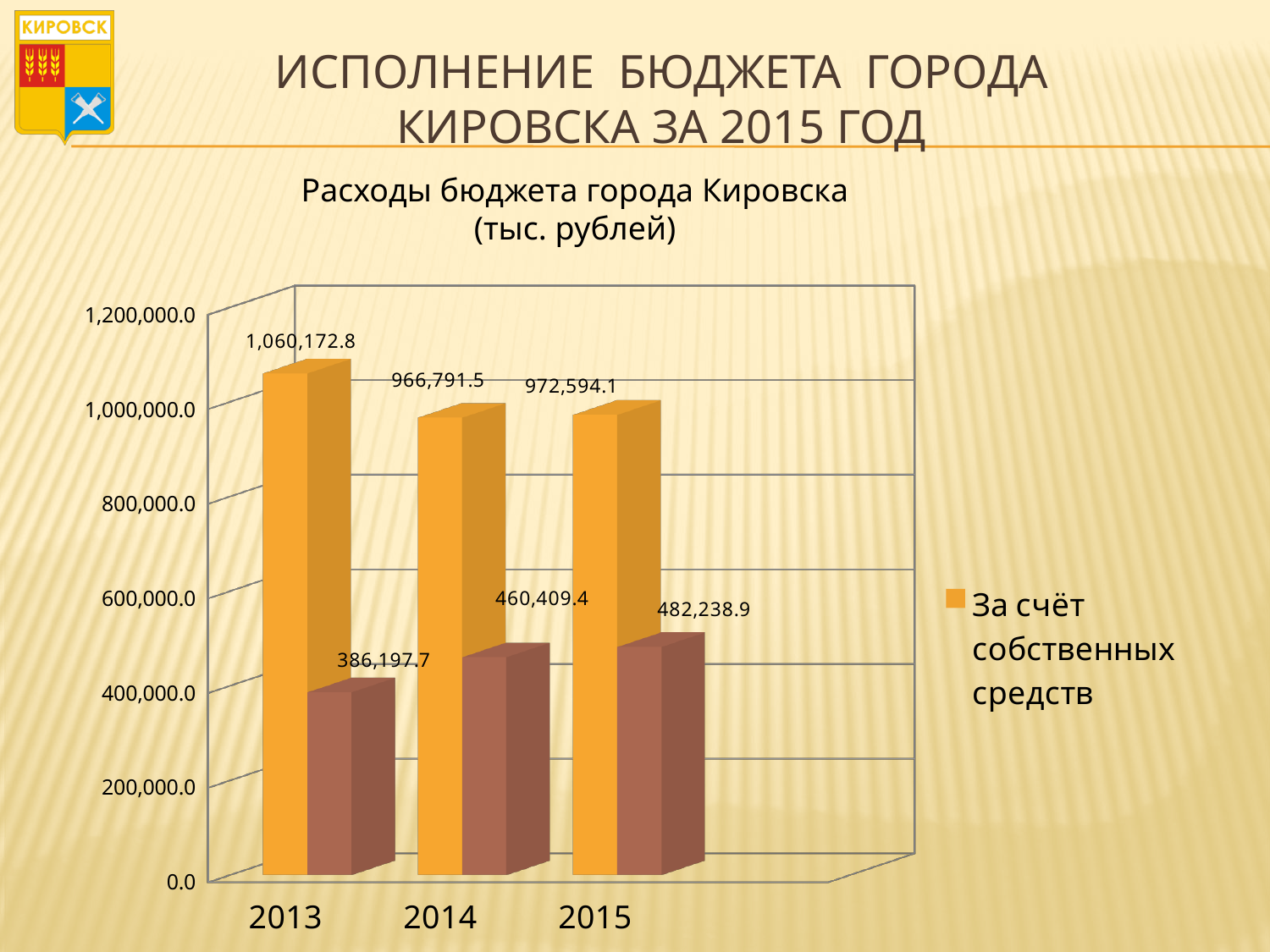
What is the title of the chart? Расходы бюджета города Кировска (тыс. рублей) By how much does the brown bar for 2015 exceed the brown bar for 2014? 21,829.5 What is the value of the orange bar for 2013? 1,060,172.8 What is the difference between the orange bar and the brown bar for 2013? 673,975.1 What is the value of the brown bar for 2014? 460,409.4 How many years are shown on the x axis? 3 What is the value of the brown bar for 2015? 482,238.9 Do the brown bars rise or fall from 2013 to 2015? rise Which is larger, the orange bar for 2014 or the orange bar for 2015? 2015 In which year is the brown bar the lowest? 2013 In which year is the orange bar the highest? 2013 What kind of chart is shown on the slide? bar chart